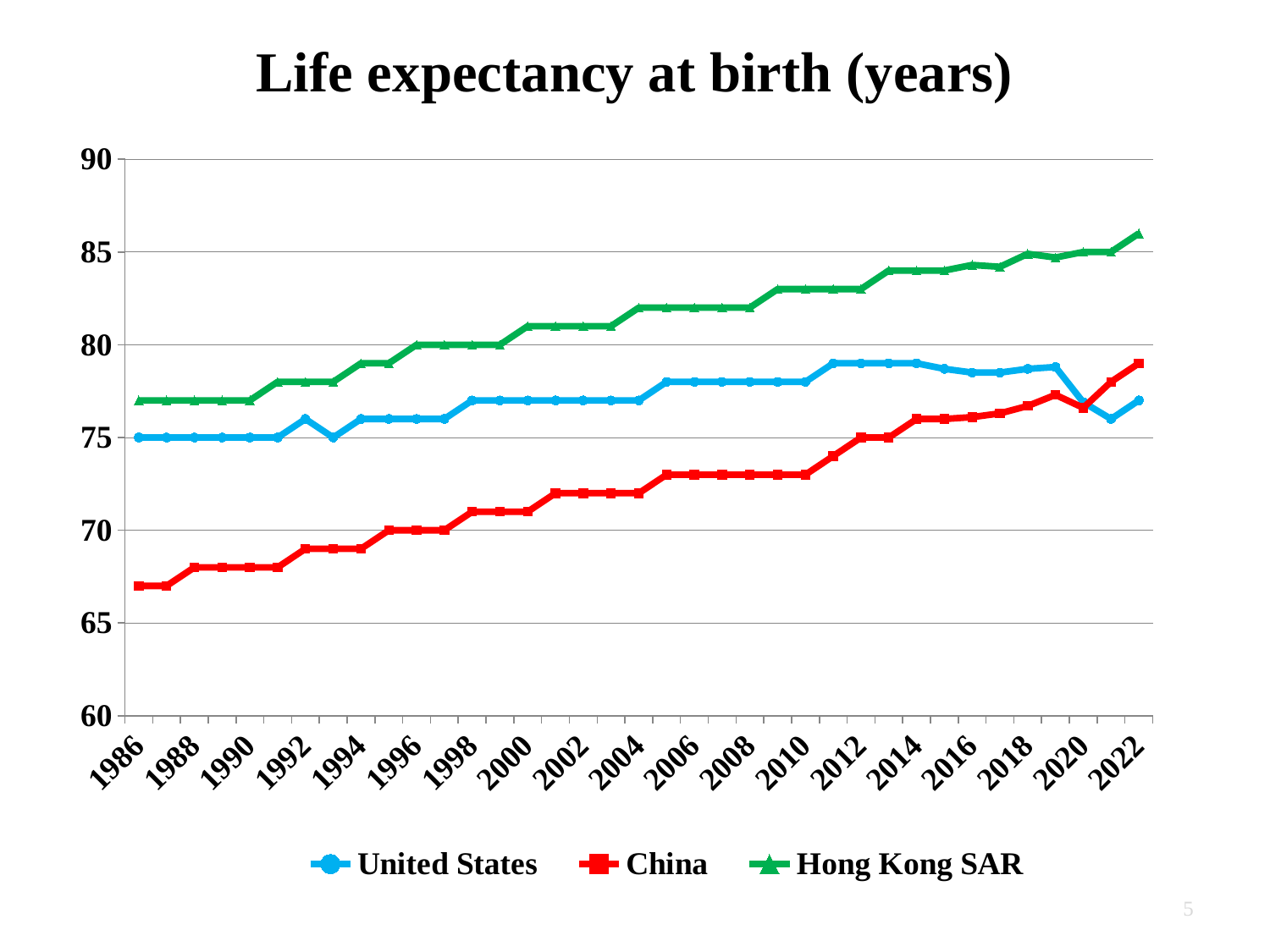
What is the title of the chart? Life expectancy at birth (years) Is the value for Hong Kong SAR in 2022 greater or less than 85? greater Which series is drawn in red? China What is the value for the United States in 1986? 75 What kind of chart is shown on the slide? Line chart Which series has the highest value in 2022? Hong Kong SAR What is the value for China in 1996? 70 Which series has the lowest value in 1986? China Does the value for China rise or fall from 1986 to 2022? Rise What is the value for Hong Kong SAR in 1996? 80 Is the value for China in 1986 greater or less than 70? less How many series does the legend list? 3